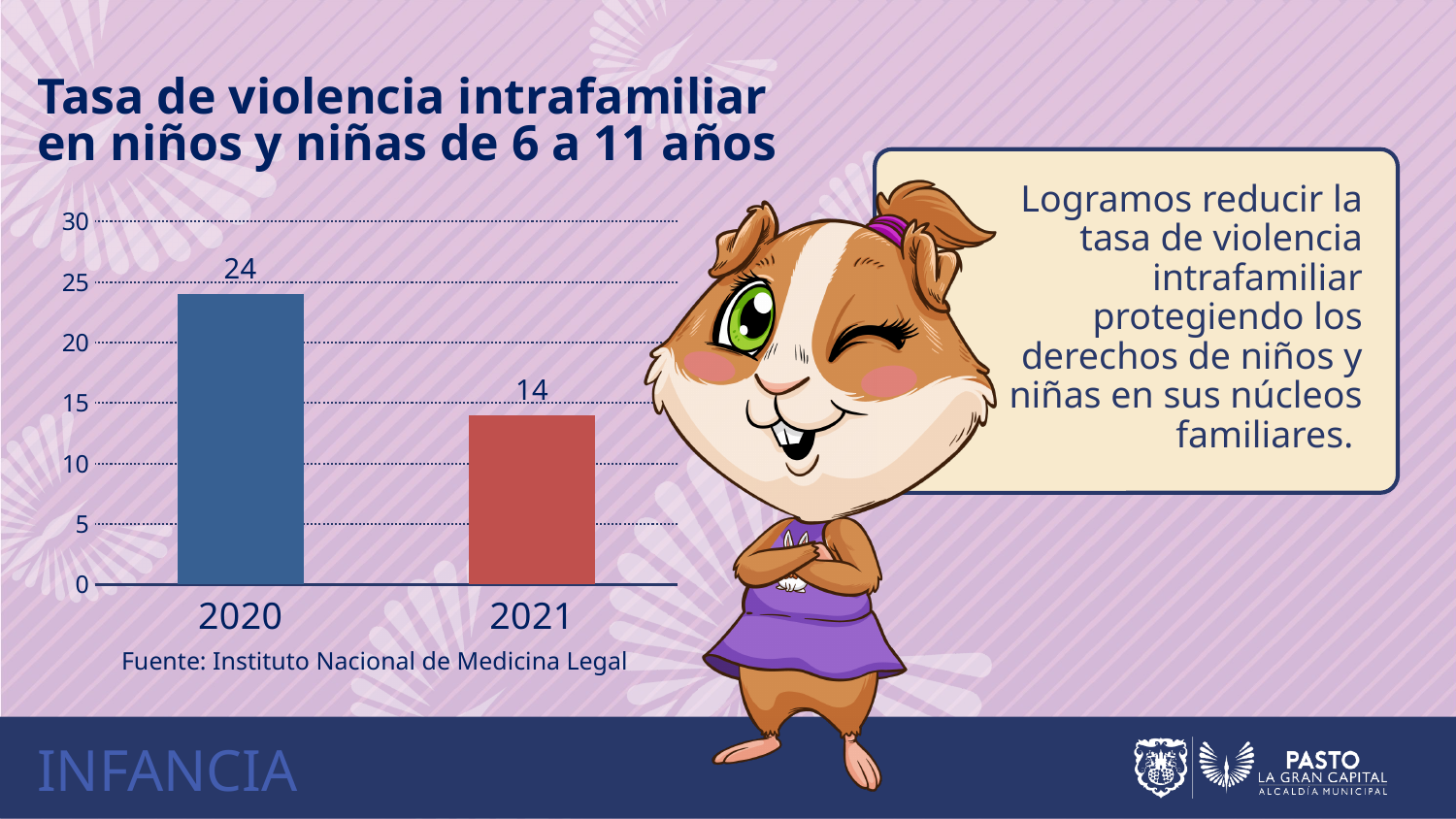
What is the value for 2020? 24 How many years are shown on the chart? 2 What is the title of the chart? Tasa de violencia intrafamiliar en niños y niñas de 6 a 11 años Which year has the highest value? 2020 Which is larger, the value for 2020 or the value for 2021? 2020 Is the value for 2021 greater or less than 15? less What kind of chart is shown on the slide? bar chart What is the difference between the values for 2020 and 2021? 10 Which year has the lowest value? 2021 What is the value for 2021? 14 Do the values rise or fall from 2020 to 2021? fall Is the value for 2020 greater or less than 20? greater